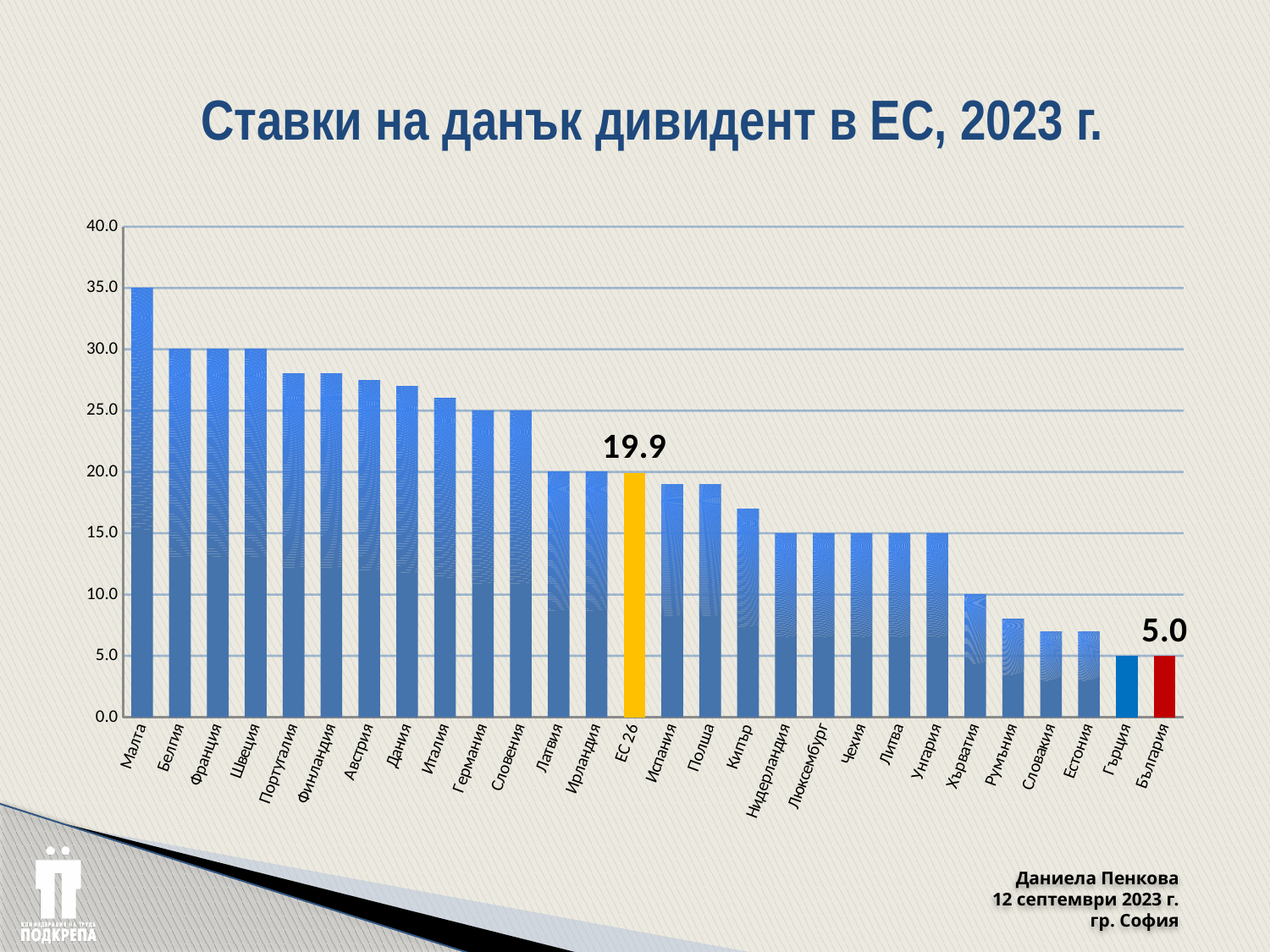
Which category has the highest value? Малта What is the value shown for България? 5.0 Do the values generally rise or fall from left to right along the x axis? fall What kind of chart is shown on the slide? bar chart What is the value shown for ЕС 26? 19.9 What is the value for Малта? 35.0 Is the value for Румъния greater or less than 10.0? less What is the difference between the value for ЕС 26 and the value for България? 14.9 What is the title of the chart? Ставки на данък дивидент в ЕС, 2023 г. How many bars are plotted in the chart? 28 Is the value for Португалия greater or less than 25.0? greater Which is larger, the value for Белгия or the value for Унгария? Белгия